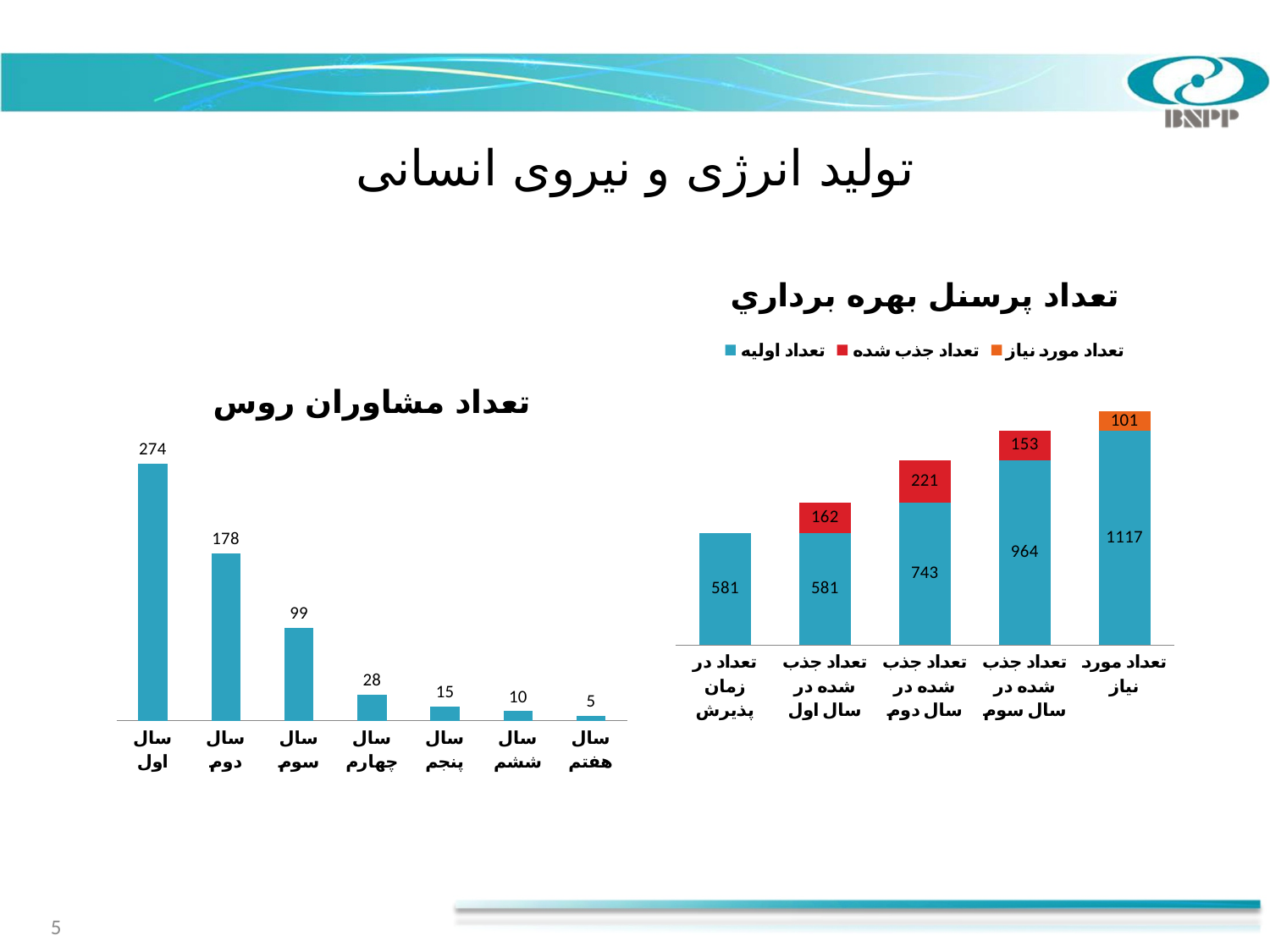
In the chart titled "تعداد پرسنل بهره برداري", what is the total of the stacked bar for تعداد جذب شده در سال سوم? 1117 In the chart titled "تعداد پرسنل بهره برداري", what is the value of the تعداد جذب شده segment for تعداد جذب شده در سال اول? 162 In the chart titled "تعداد پرسنل بهره برداري", what is the value of the تعداد اولیه segment for تعداد جذب شده در سال دوم? 743 In the chart titled "تعداد پرسنل بهره برداري", how many series does the legend list? 3 In the chart titled "تعداد پرسنل بهره برداري", which is larger: the تعداد جذب شده segment for سال دوم or for سال سوم? سال دوم In the chart titled "تعداد مشاوران روس", what is the value for سال چهارم? 28 What kind of chart is the one titled "تعداد پرسنل بهره برداري"? stacked bar chart In the chart titled "تعداد مشاوران روس", which category has the lowest value? سال هفتم In the chart titled "تعداد مشاوران روس", what is the difference between the values for سال اول and سال دوم? 96 In the chart titled "تعداد مشاوران روس", what is the value for سال اول? 274 In the chart titled "تعداد مشاوران روس", how many categories are shown on the x axis? 7 In the chart titled "تعداد مشاوران روس", do the values rise or fall from سال اول to سال هفتم? fall